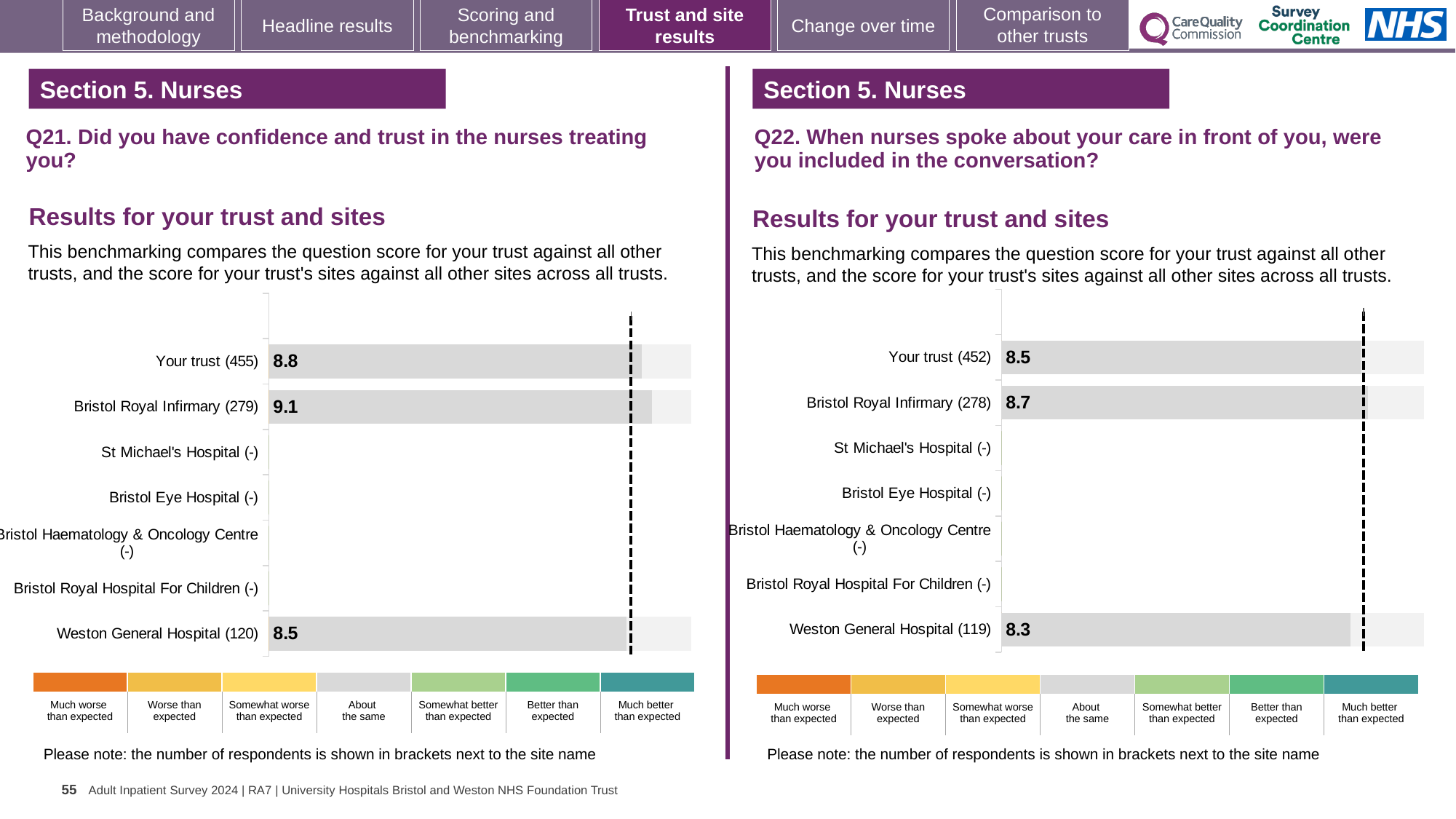
In the Q22 chart on the right, which site has the highest score? Bristol Royal Infirmary (278) In the Q22 chart on the right, what is the difference between the scores for Bristol Royal Infirmary and Your trust? 0.2 In the Q21 chart on the left, what is the score for Bristol Royal Infirmary (279)? 9.1 What type of chart is used for the Q22 results on the right? Bar chart In the Q21 chart on the left, what is the score for Your trust (455)? 8.8 In the Q21 chart on the left, what is the score for Weston General Hospital (120)? 8.5 In the Q21 chart on the left, which of the sites with a printed score has the lowest score? Weston General Hospital (120) In the Q21 chart on the left, what is the difference between the scores for Bristol Royal Infirmary and Weston General Hospital? 0.6 In the Q22 chart on the right, which is larger: the score for Your trust or the score for Weston General Hospital? Your trust In the Q22 chart on the right, what is the score for Your trust (452)? 8.5 In the Q22 chart on the right, what is the score for Weston General Hospital (119)? 8.3 How many site categories are listed on the y axis of the Q21 chart on the left? 7